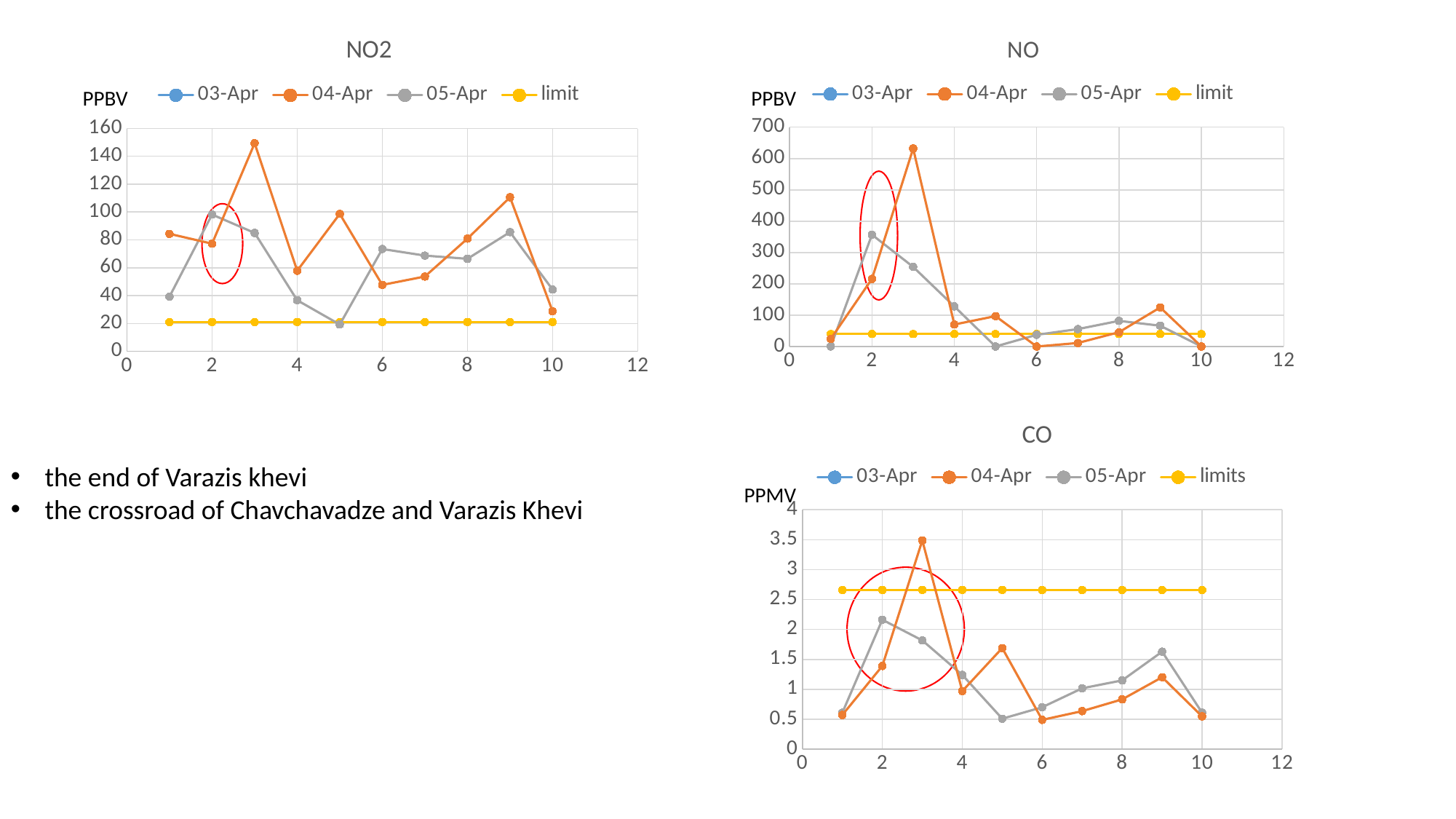
In the NO2 chart, at which x value does the 04-Apr series reach its highest point? 3 How many data points does the 04-Apr series have in the CO chart? 10 How many series does the legend of the NO chart list? 4 In the NO chart, is the 04-Apr value at x = 3 greater or less than 600? greater In the NO2 chart, is the 05-Apr value at x = 5 greater or less than 40? less What kind of chart is the NO2 chart? line chart In the NO chart, at which x value does the 04-Apr series reach its highest point? 3 In the NO chart, at x = 2, which series has the larger value, 04-Apr or 05-Apr? 05-Apr In the CO chart, at x = 2, which series has the larger value, 04-Apr or 05-Apr? 05-Apr In the CO chart, is the 04-Apr value at x = 3 greater or less than 3? greater What unit label is shown on the y axis of the CO chart? PPMV